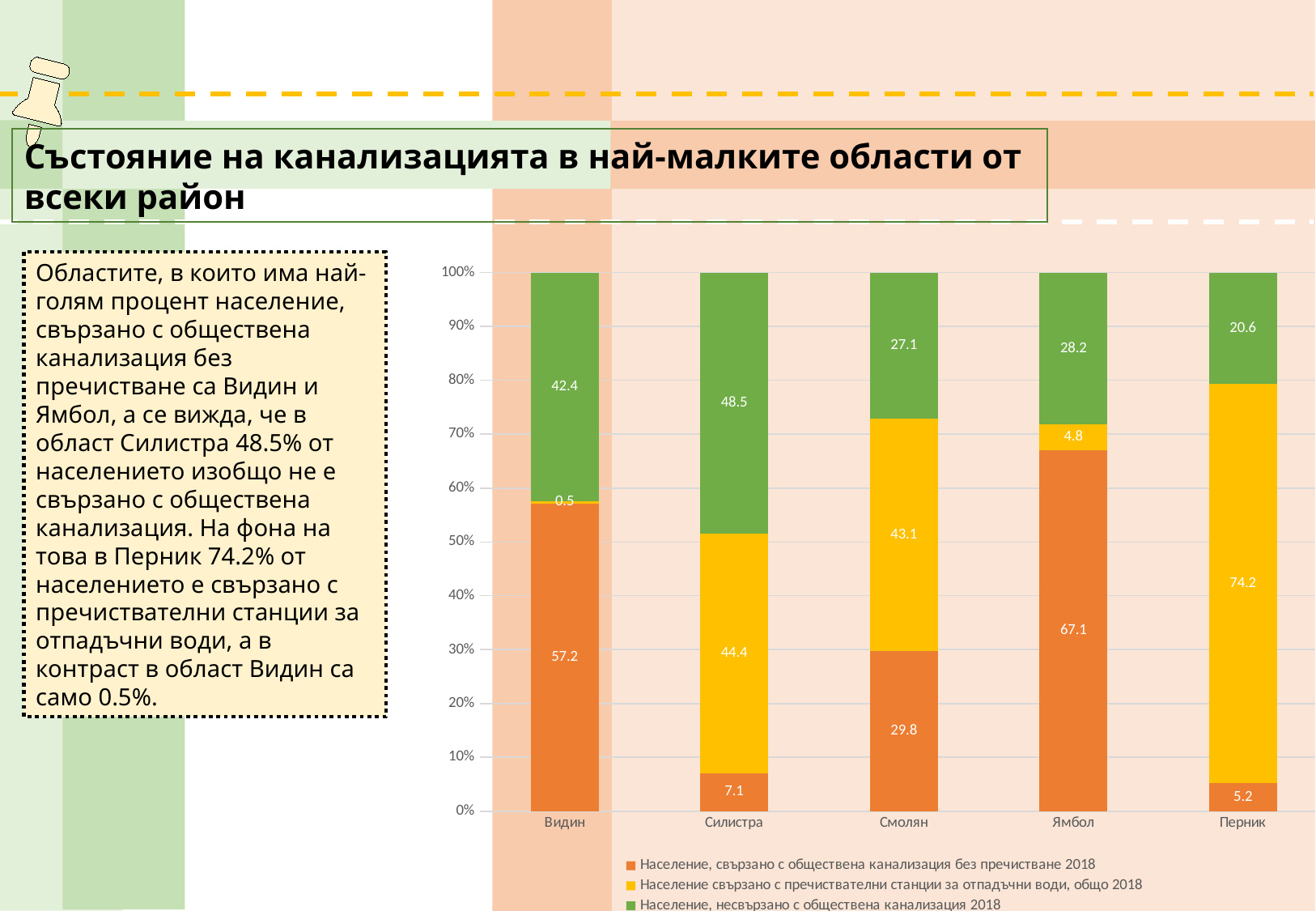
What type of chart is shown on the slide? stacked bar chart Which region has the lowest value in the series 'Население свързано с пречиствателни станции за отпадъчни води, общо 2018'? Видин Which region has the highest value in the series 'Население, свързано с обществена канализация без пречистване 2018'? Ямбол Which is larger: the 'Население, свързано с обществена канализация без пречистване 2018' value for Смолян or for Перник? Смолян What is the value for Перник in the series 'Население свързано с пречиствателни станции за отпадъчни води, общо 2018'? 74.2 How many series does the chart legend list? 3 Which colour represents the series 'Население, несвързано с обществена канализация 2018' in the chart? green What is the value for Видин in the series 'Население, свързано с обществена канализация без пречистване 2018'? 57.2 How many regions (categories) are shown on the x axis of the chart? 5 What is the difference between the 'Население, несвързано с обществена канализация 2018' values for Силистра and Перник? 27.9 What is the value for Ямбол in the series 'Население свързано с пречиствателни станции за отпадъчни води, общо 2018'? 4.8 What is the value for Силистра in the series 'Население, несвързано с обществена канализация 2018'? 48.5